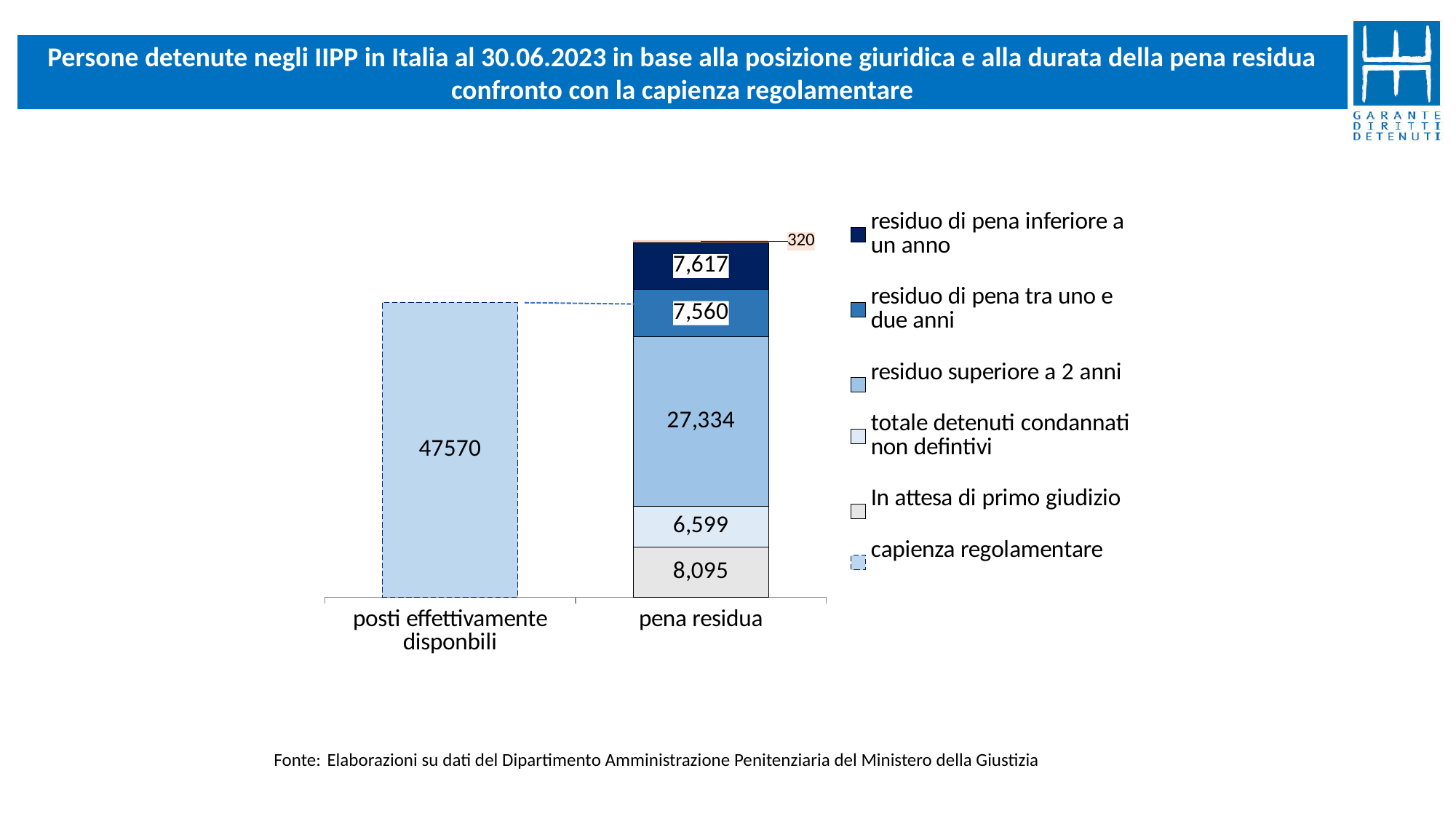
Among the legend-listed segments of the pena residua bar, which has the smallest value? totale detenuti condannati non defintivi In the pena residua bar, what is the value of the residuo superiore a 2 anni segment? 27,334 What value is shown for the posti effettivamente disponbili bar (capienza regolamentare)? 47570 Which segment of the pena residua bar is the largest? residuo superiore a 2 anni How many categories are shown on the x axis? 2 How much larger is the residuo superiore a 2 anni segment than the In attesa di primo giudizio segment? 19,239 What is the difference between the residuo di pena inferiore a un anno segment (7,617) and the residuo di pena tra uno e due anni segment (7,560)? 57 In the pena residua bar, what is the value of the In attesa di primo giudizio segment? 8,095 What kind of chart is shown on the slide? Stacked bar chart In the pena residua bar, what is the value of the residuo di pena inferiore a un anno segment? 7,617 Which is larger: the In attesa di primo giudizio segment or the totale detenuti condannati non defintivi segment? In attesa di primo giudizio How many entries does the legend list? 6